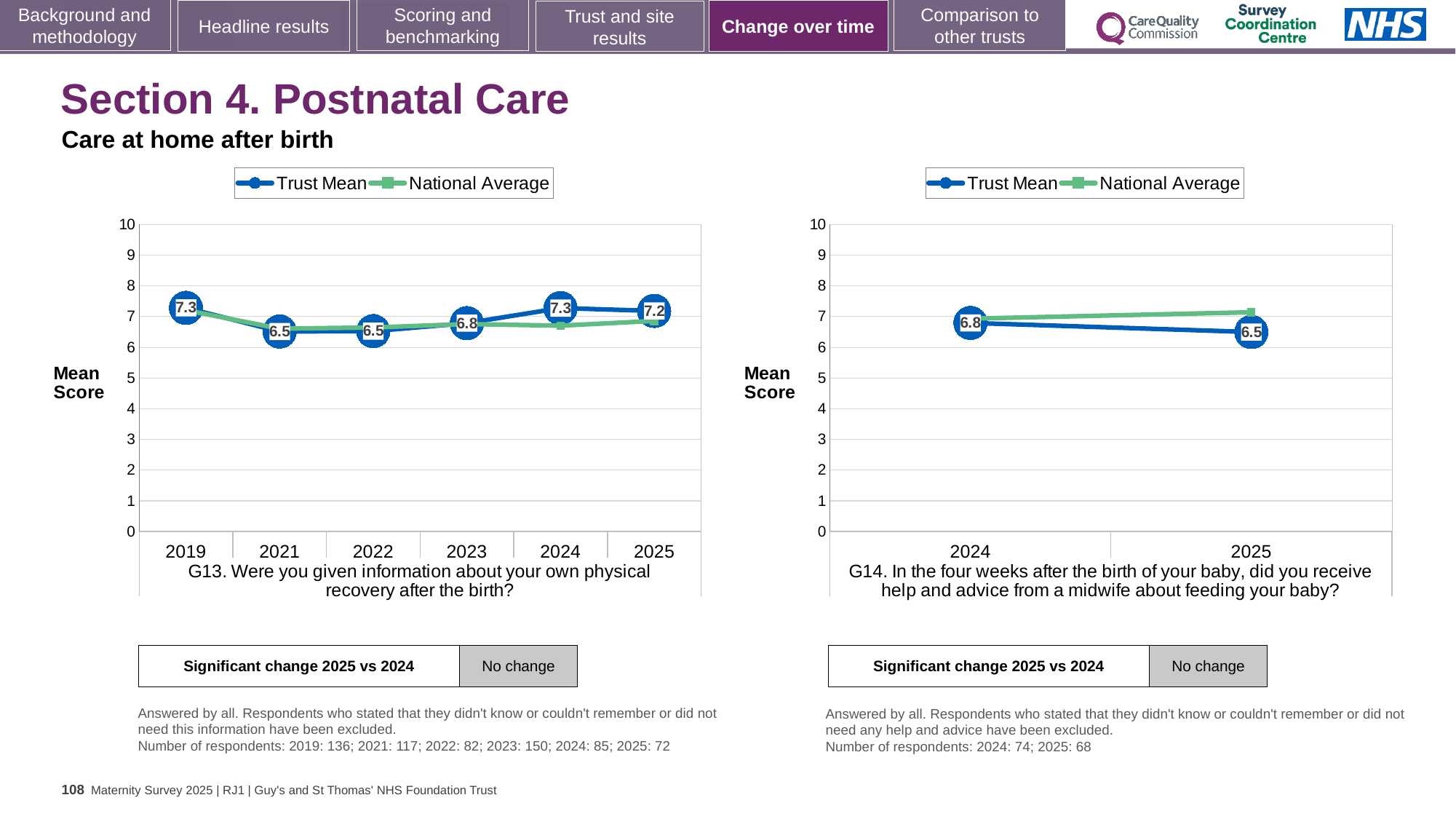
In the G13 chart on the left, what is the Trust Mean for 2019? 7.3 In the G14 chart on the right, what is the Trust Mean for 2025? 6.5 In the G13 chart on the left, what is the Trust Mean for 2023? 6.8 In the G13 chart on the left, which year has the larger Trust Mean, 2019 or 2021? 2019 In the G14 chart on the right, what is the difference between the Trust Mean for 2024 and 2025? 0.3 How many series does the legend of the G14 chart on the right list? 2 In the G13 chart on the left, what is the Trust Mean for 2025? 7.2 In the G14 chart on the right, does the Trust Mean rise or fall from 2024 to 2025? fall In the G14 chart on the right, what is the Trust Mean for 2024? 6.8 In the G13 chart on the left, what is the difference between the Trust Mean for 2024 and 2025? 0.1 In the G13 chart on the left, is the National Average for 2024 greater or less than 7? less How many years are plotted in the G13 chart on the left? 6